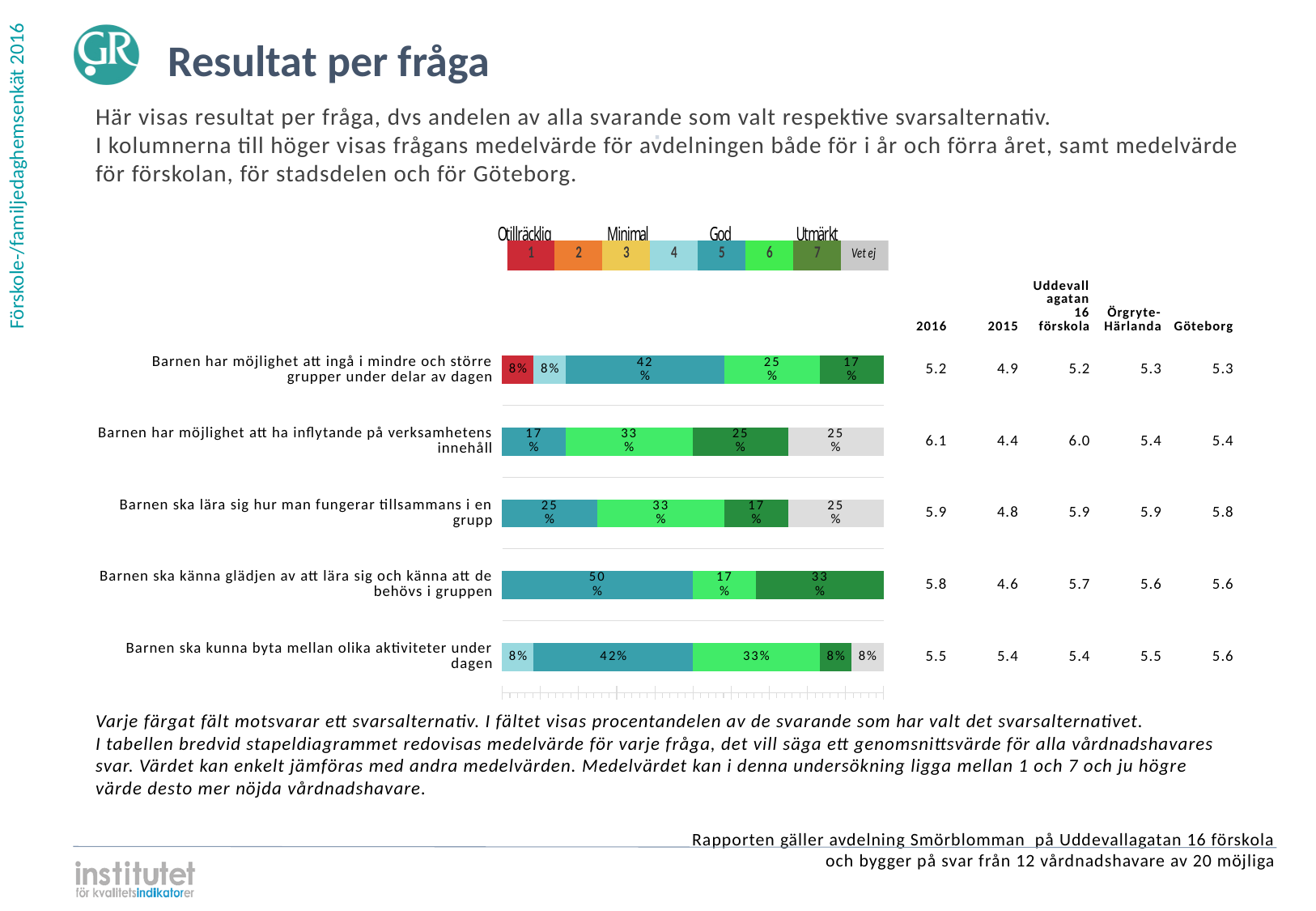
For 'Barnen ska känna glädjen av att lära sig och känna att de behövs i gruppen', which is larger: the share for answer 6 or the share for answer 7? Answer 7 What percentage of respondents chose answer 5 for 'Barnen ska känna glädjen av att lära sig och känna att de behövs i gruppen'? 50% How many answer alternatives does the legend above the chart list, including 'Vet ej'? 8 Which answer alternative has the largest share for 'Barnen ska kunna byta mellan olika aktiviteter under dagen'? 5 What is the total of the segments in the bar for 'Barnen ska känna glädjen av att lära sig och känna att de behövs i gruppen'? 100% What percentage chose answer 1 (Otillräcklig) for 'Barnen har möjlighet att ingå i mindre och större grupper under delar av dagen'? 8% What percentage chose 'Vet ej' for 'Barnen har möjlighet att ha inflytande på verksamhetens innehåll'? 25% What kind of chart is shown on the slide? Stacked bar chart For 'Barnen ska lära sig hur man fungerar tillsammans i en grupp', what is the difference between the share for answer 6 and the share for answer 7? 16% What is the 2016 mean value shown for 'Barnen har möjlighet att ha inflytande på verksamhetens innehåll'? 6.1 How many questions (categories) are plotted in the bar chart? 5